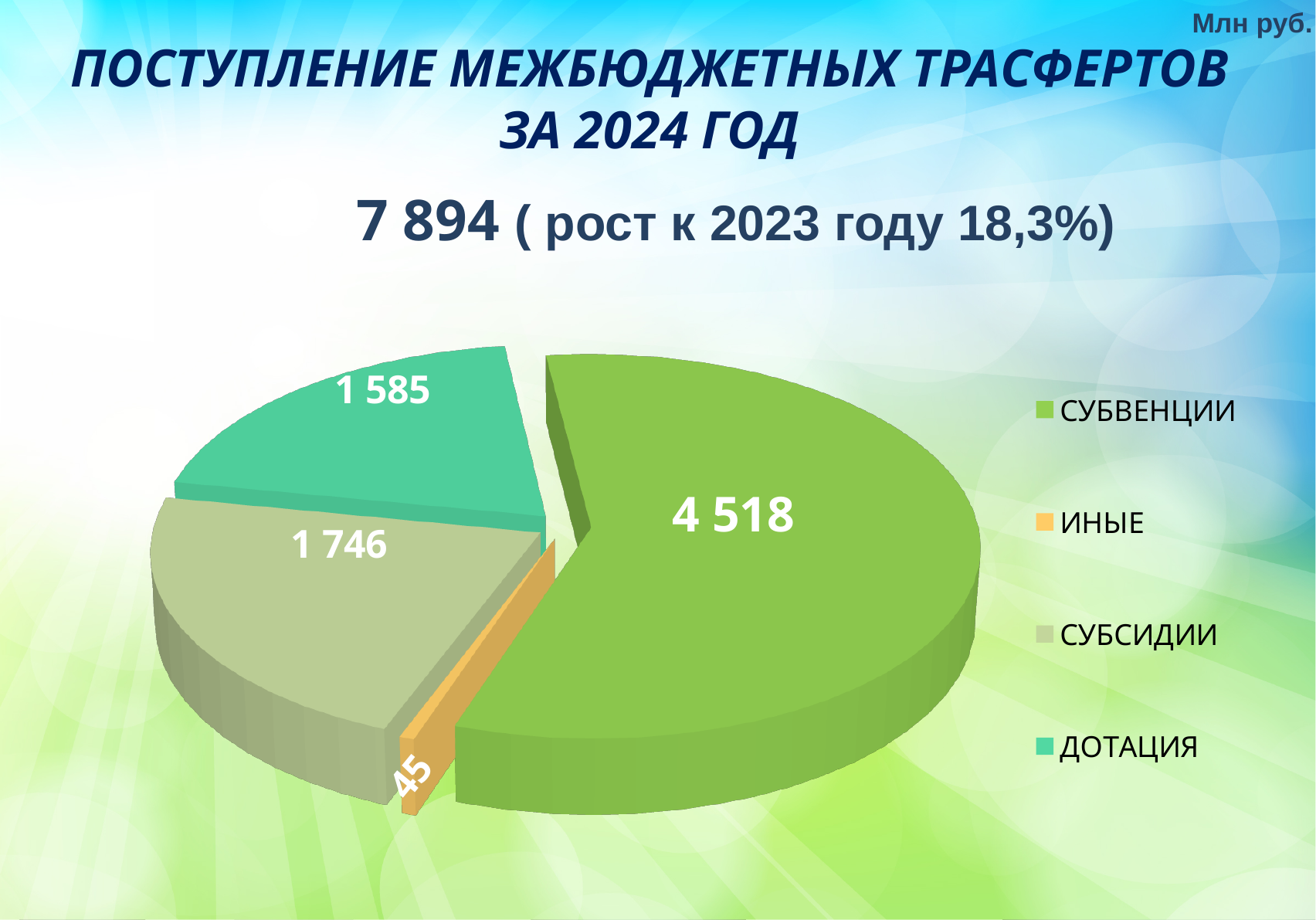
What colour is the ИНЫЕ slice in the pie chart? Orange What is the total of all slices in the pie chart? 7 894 What kind of chart is shown on the slide? Pie chart What is the value for ДОТАЦИЯ in the pie chart? 1 585 What is the value for СУБВЕНЦИИ in the pie chart? 4 518 Which category has the smallest slice in the pie chart? ИНЫЕ What is the difference between the values for СУБСИДИИ and ДОТАЦИЯ? 161 What is the value for СУБСИДИИ in the pie chart? 1 746 Which is larger, СУБСИДИИ or ДОТАЦИЯ? СУБСИДИИ Which category has the largest slice in the pie chart? СУБВЕНЦИИ How many slices does the pie chart have? 4 What is the value for ИНЫЕ in the pie chart? 45